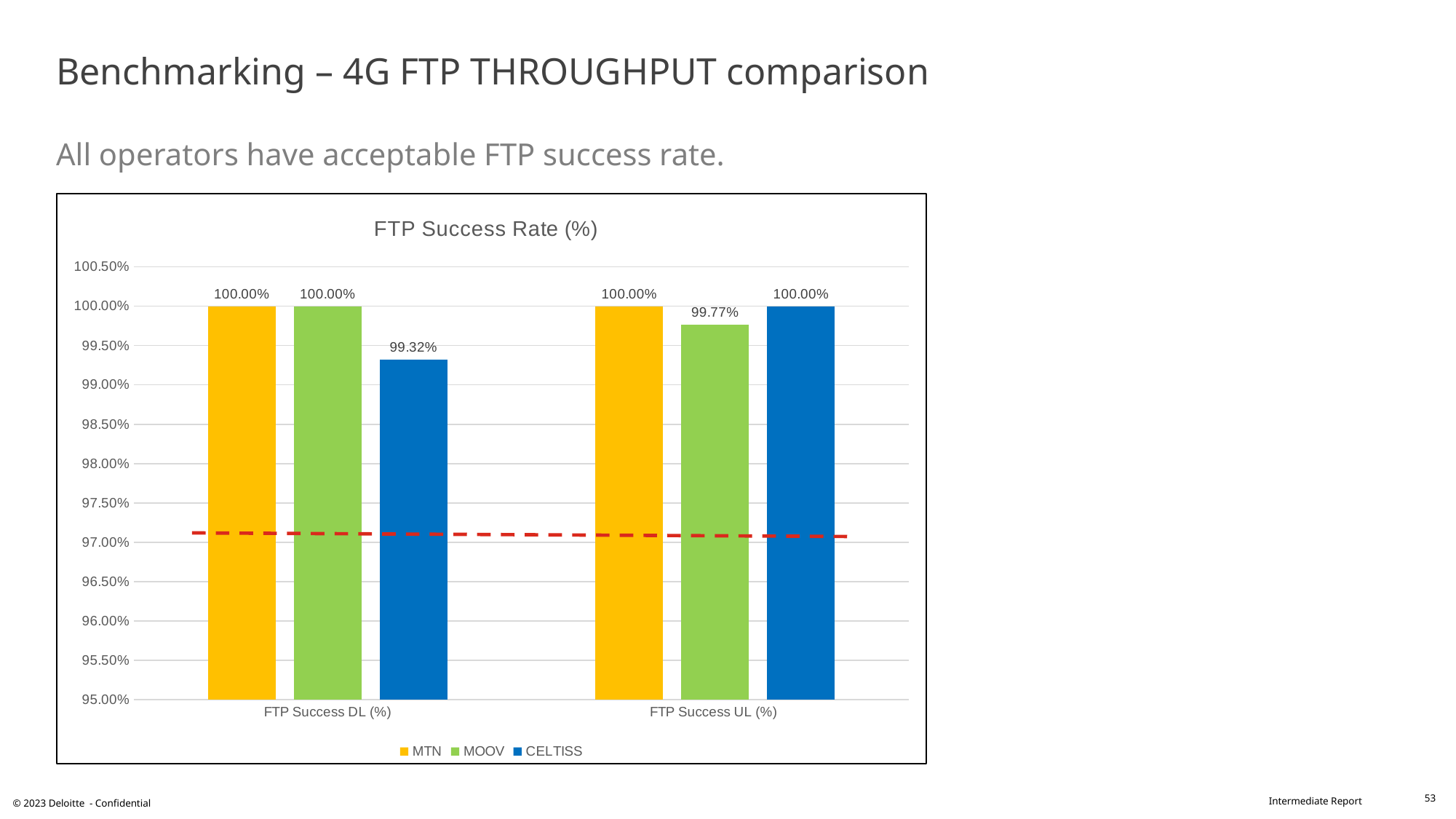
What is the FTP Success DL (%) value for MTN? 100.00% What kind of chart is shown on the slide? Bar chart What is the FTP Success DL (%) value for CELTISS? 99.32% Which is larger: CELTISS's FTP Success DL (%) or CELTISS's FTP Success UL (%)? FTP Success UL (%) What is the title of the chart? FTP Success Rate (%) How many series does the legend list? 3 Which operator has the lowest FTP Success DL (%)? CELTISS What is the FTP Success UL (%) value for CELTISS? 100.00% Which operator has the lowest FTP Success UL (%)? MOOV What is the difference between MTN and CELTISS for FTP Success DL (%)? 0.68% What is the difference between CELTISS and MOOV for FTP Success UL (%)? 0.23% What is the FTP Success UL (%) value for MOOV? 99.77%